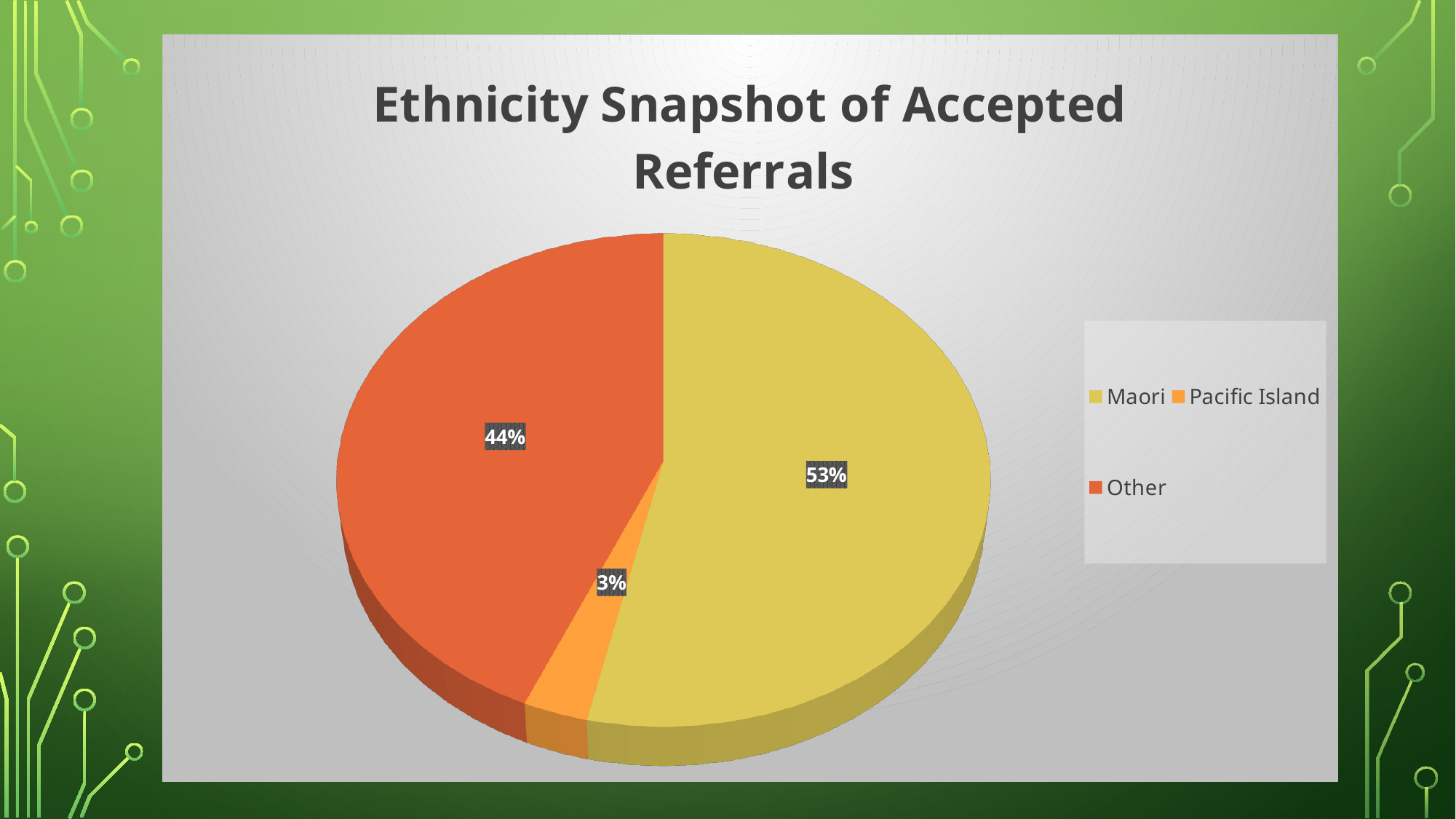
Which is larger, the Maori share or the Other share? Maori What is the title of the chart? Ethnicity Snapshot of Accepted Referrals Which ethnicity has the smallest share of accepted referrals? Pacific Island What percentage of accepted referrals are Maori? 53% What kind of chart is shown on the slide? Pie chart What is the difference in percentage points between the Maori and Other shares? 9 How many ethnicity categories are shown in the pie chart? 3 What percentage of accepted referrals are Pacific Island? 3% What is the difference in percentage points between the Other and Pacific Island shares? 41 What percentage of accepted referrals are Other? 44% Which ethnicity has the largest share of accepted referrals? Maori Which colour represents the Other category in the pie chart? Orange-red